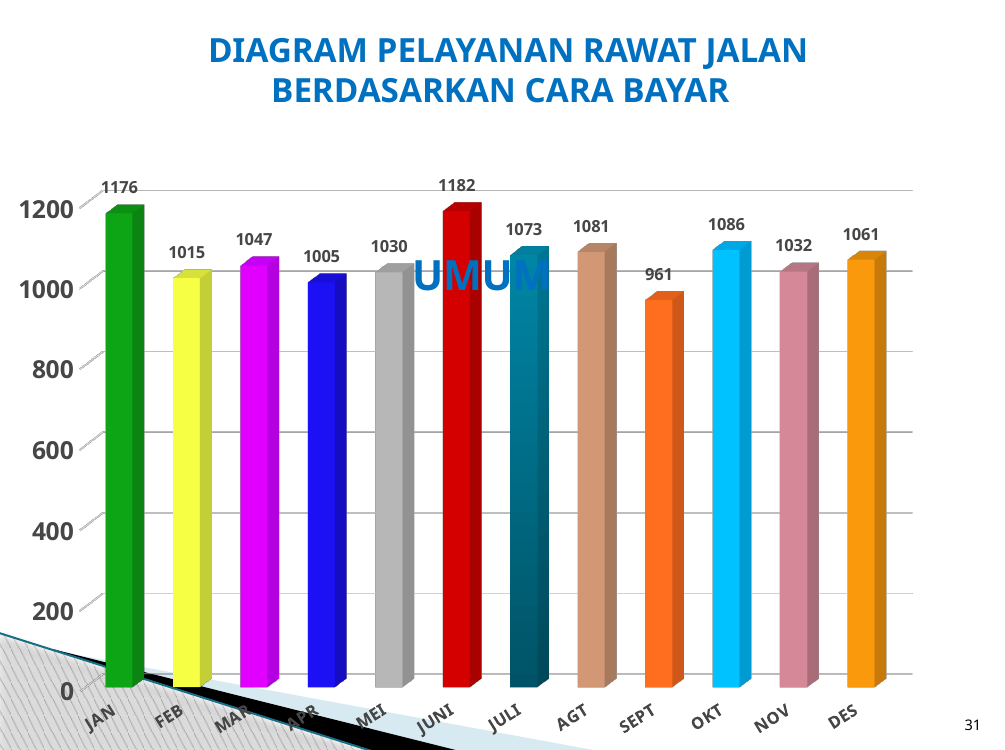
Is the value for SEPT greater or less than 1000? less Which month has the highest value? JUNI Which is larger, the value for MAR or the value for APR? MAR Which month has the lowest value? SEPT What is the value for SEPT? 961 What is the value for OKT? 1086 What is the difference between the values for JAN and FEB? 161 How many months are shown on the x axis? 12 What is the value for JUNI? 1182 What kind of chart is shown on the slide? bar chart What label is printed in the middle of the chart area? UMUM What is the difference between the values for JUNI and SEPT? 221